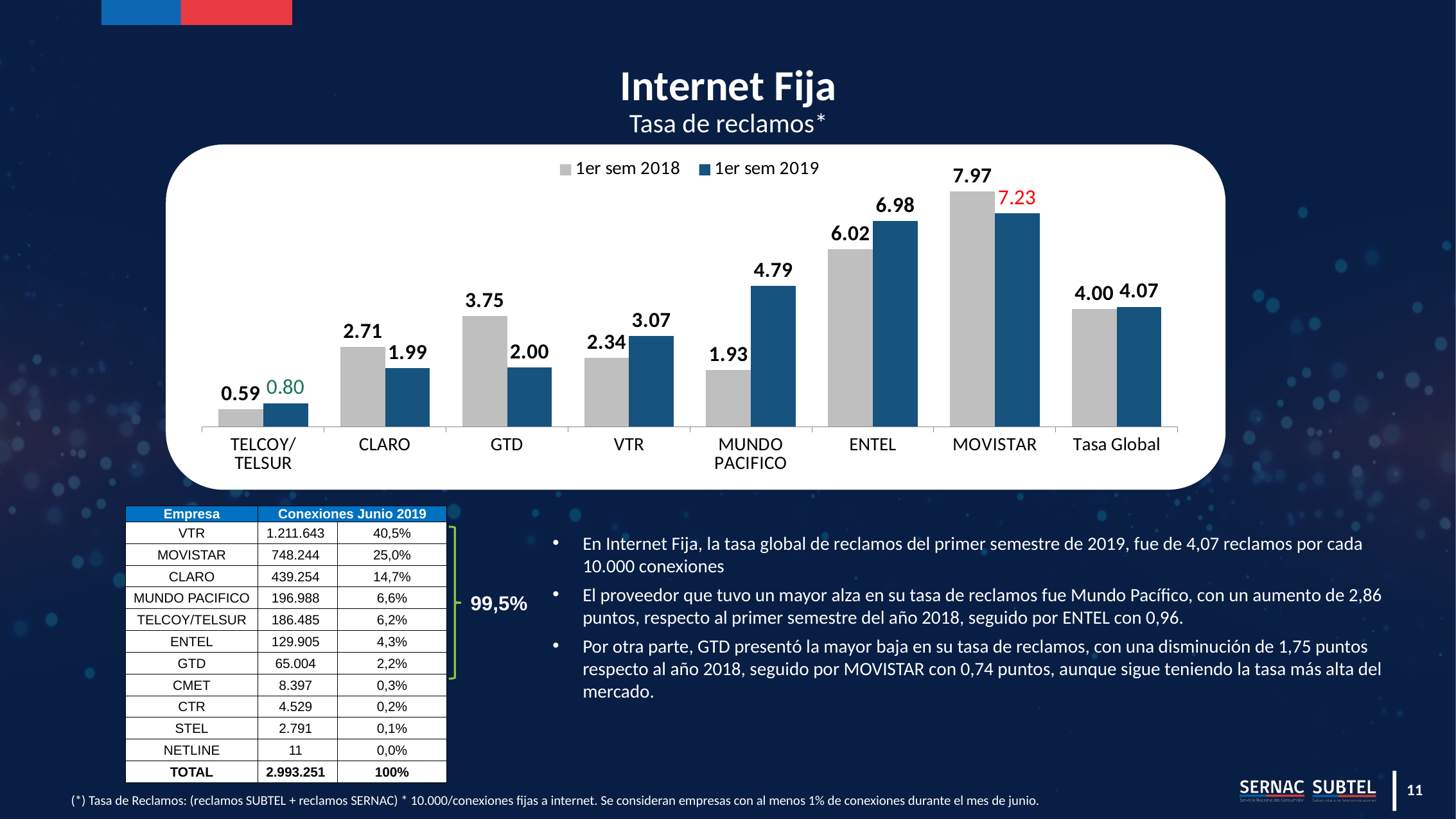
How many series does the chart legend list? 2 What is the Tasa Global value for 1er sem 2019? 4.07 Which category has the lowest value in the 1er sem 2018 series? TELCOY/TELSUR What is the difference between the 1er sem 2018 and 1er sem 2019 values for GTD? 1.75 What is the value for MOVISTAR in the 1er sem 2019 series? 7.23 Which category has the highest value in the 1er sem 2019 series? MOVISTAR How many categories are shown on the x axis of the chart? 8 What colour are the bars for the 1er sem 2019 series? Blue For CLARO, which is larger: the 1er sem 2018 value or the 1er sem 2019 value? 1er sem 2018 What is the difference between the 1er sem 2019 and 1er sem 2018 values for MUNDO PACIFICO? 2.86 What kind of chart is shown on the slide? Bar chart What is the value for MUNDO PACIFICO in the 1er sem 2018 series? 1.93